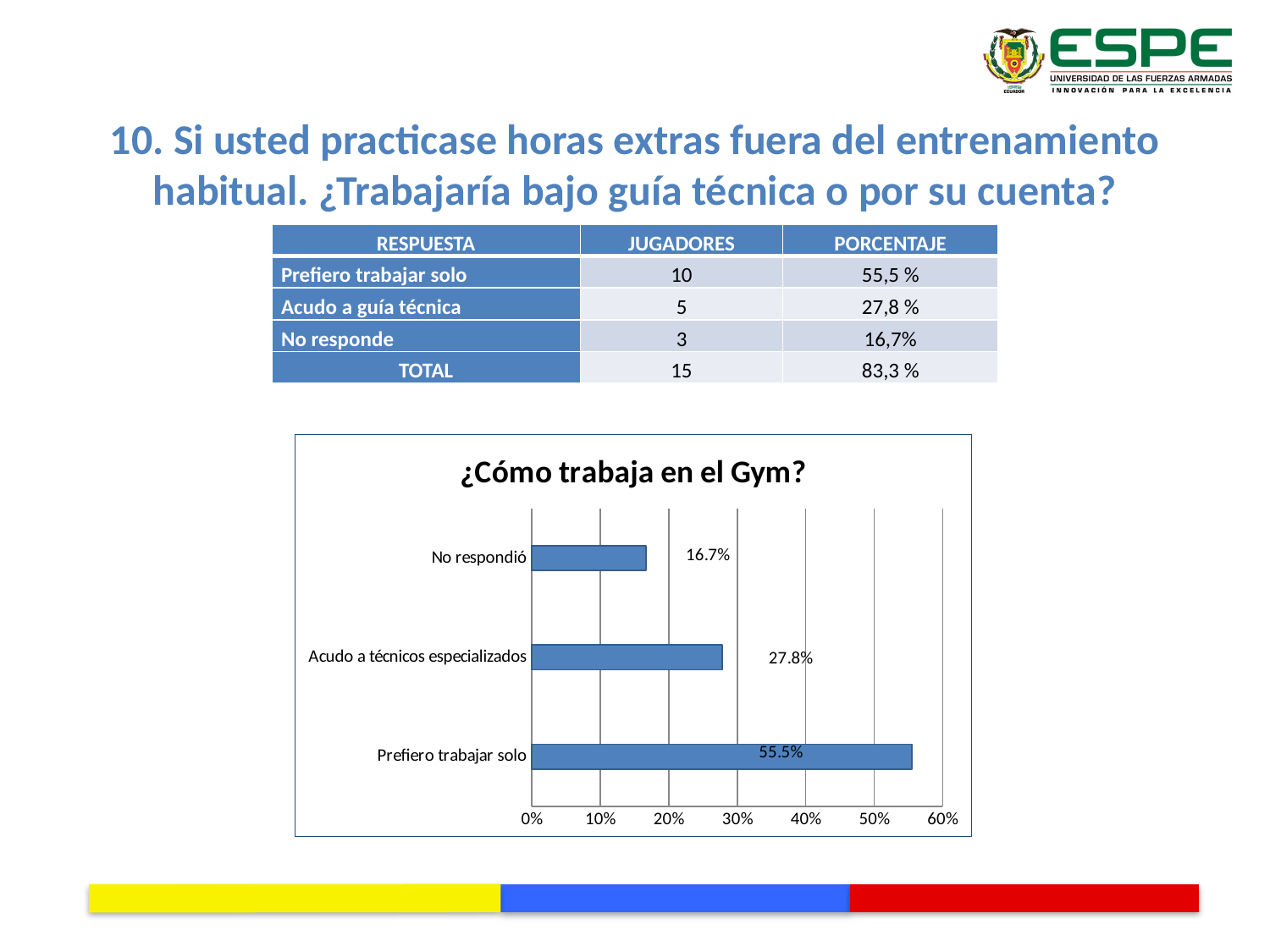
What is the value for 'No respondió' in the chart? 16.7% What is the title of the chart? ¿Cómo trabaja en el Gym? Is the value for 'Prefiero trabajar solo' greater or less than 50%? greater What is the difference between the values for 'Prefiero trabajar solo' and 'Acudo a técnicos especializados'? 27.7% What is the value for 'Prefiero trabajar solo' in the chart? 55.5% Which category has the highest value in the chart? Prefiero trabajar solo Which category has the lowest value in the chart? No respondió Which is larger: the value for 'Acudo a técnicos especializados' or 'No respondió'? Acudo a técnicos especializados What type of chart is shown on the slide? bar chart What is the value for 'Acudo a técnicos especializados' in the chart? 27.8% Is the value for 'No respondió' greater or less than 20%? less How many categories are shown in the chart? 3